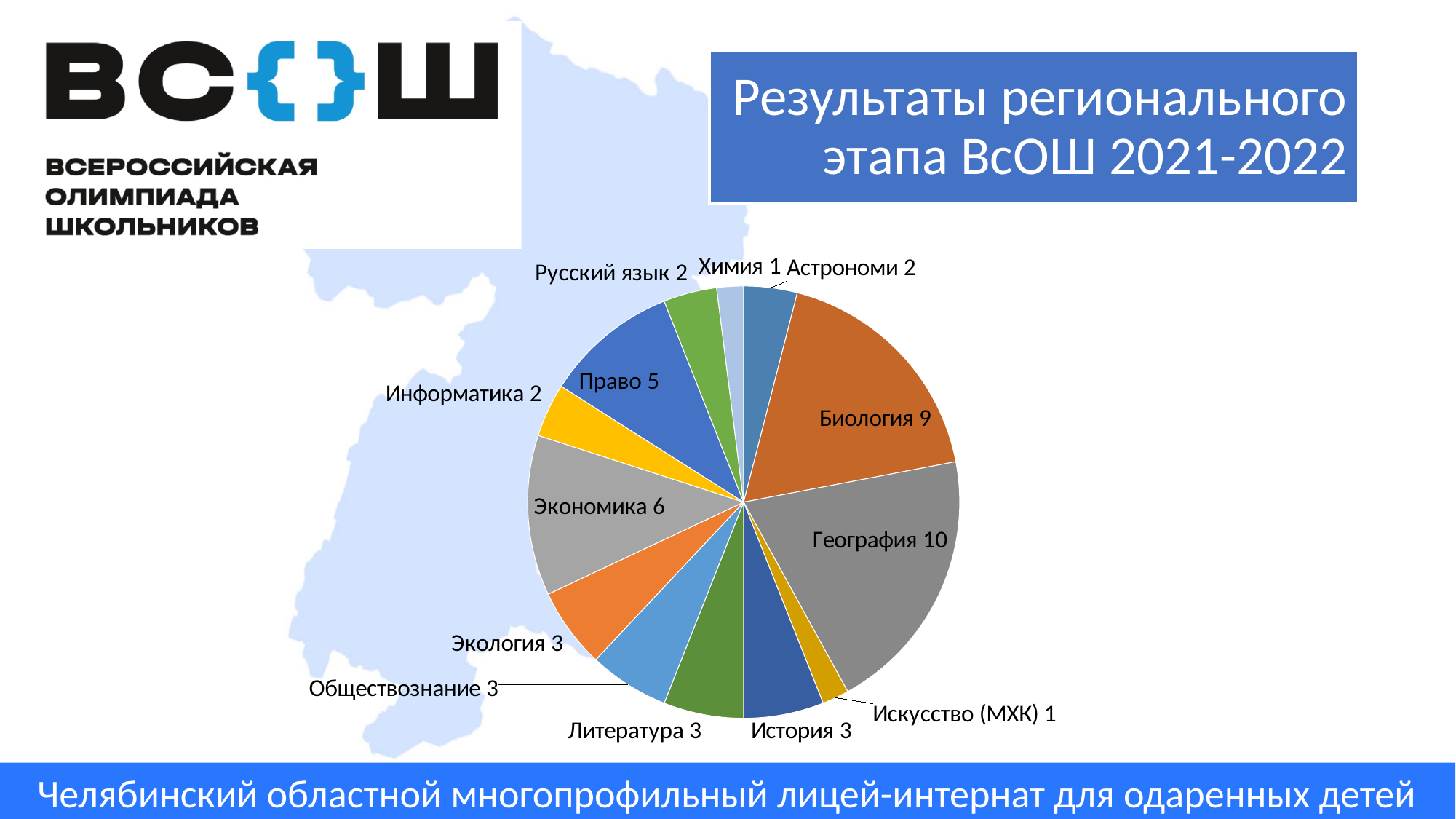
Which category has the largest slice in the pie chart? География What is the difference between the values for География and Биология? 1 What is the difference between the values for Экономика and Информатика? 4 What is the value for Экономика in the pie chart? 6 What is the value for Искусство (МХК) in the pie chart? 1 What share of the pie does География represent? 20% What is the value for Биология in the pie chart? 9 How many categories are shown in the pie chart? 13 What kind of chart is shown on the slide? Pie chart Which is larger, the value for Право or the value for Экология? Право What is the value for География in the pie chart? 10 What is the value for Право in the pie chart? 5